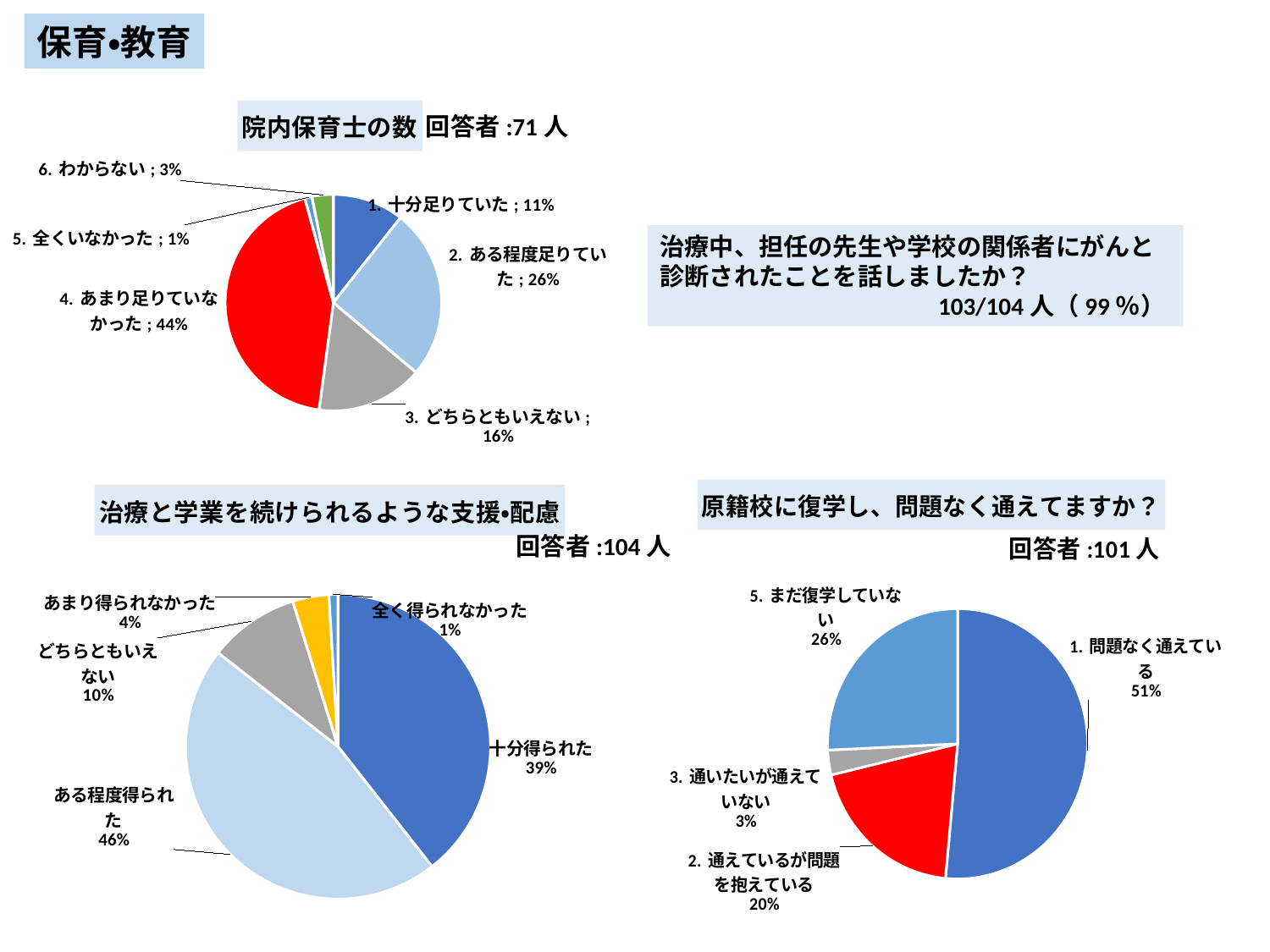
In the 院内保育士の数 pie chart, which category has the largest share? 4. あまり足りていなかった In the 院内保育士の数 pie chart, which category has the smallest share? 5. 全くいなかった In the 院内保育士の数 pie chart, how many slices are there? 6 In the 原籍校に復学し、問題なく通えてますか？ pie chart, which category has the smallest share? 3. 通いたいが通えていない In the 原籍校に復学し、問題なく通えてますか？ pie chart, what percentage is shown for 1. 問題なく通えている? 51% In the 治療と学業を続けられるような支援・配慮 pie chart, what percentage is shown for どちらともいえない? 10% In the 治療と学業を続けられるような支援・配慮 pie chart, what percentage is shown for 十分得られた? 39% In the 院内保育士の数 pie chart, what is the difference between 2. ある程度足りていた and 1. 十分足りていた? 15% What type of chart is used for 原籍校に復学し、問題なく通えてますか？? Pie chart In the 原籍校に復学し、問題なく通えてますか？ pie chart, what is the difference between 5. まだ復学していない and 2. 通えているが問題を抱えている? 6% In the 治療と学業を続けられるような支援・配慮 pie chart, which is larger: ある程度得られた or 十分得られた? ある程度得られた In the 院内保育士の数 pie chart, what percentage is shown for 4. あまり足りていなかった? 44%